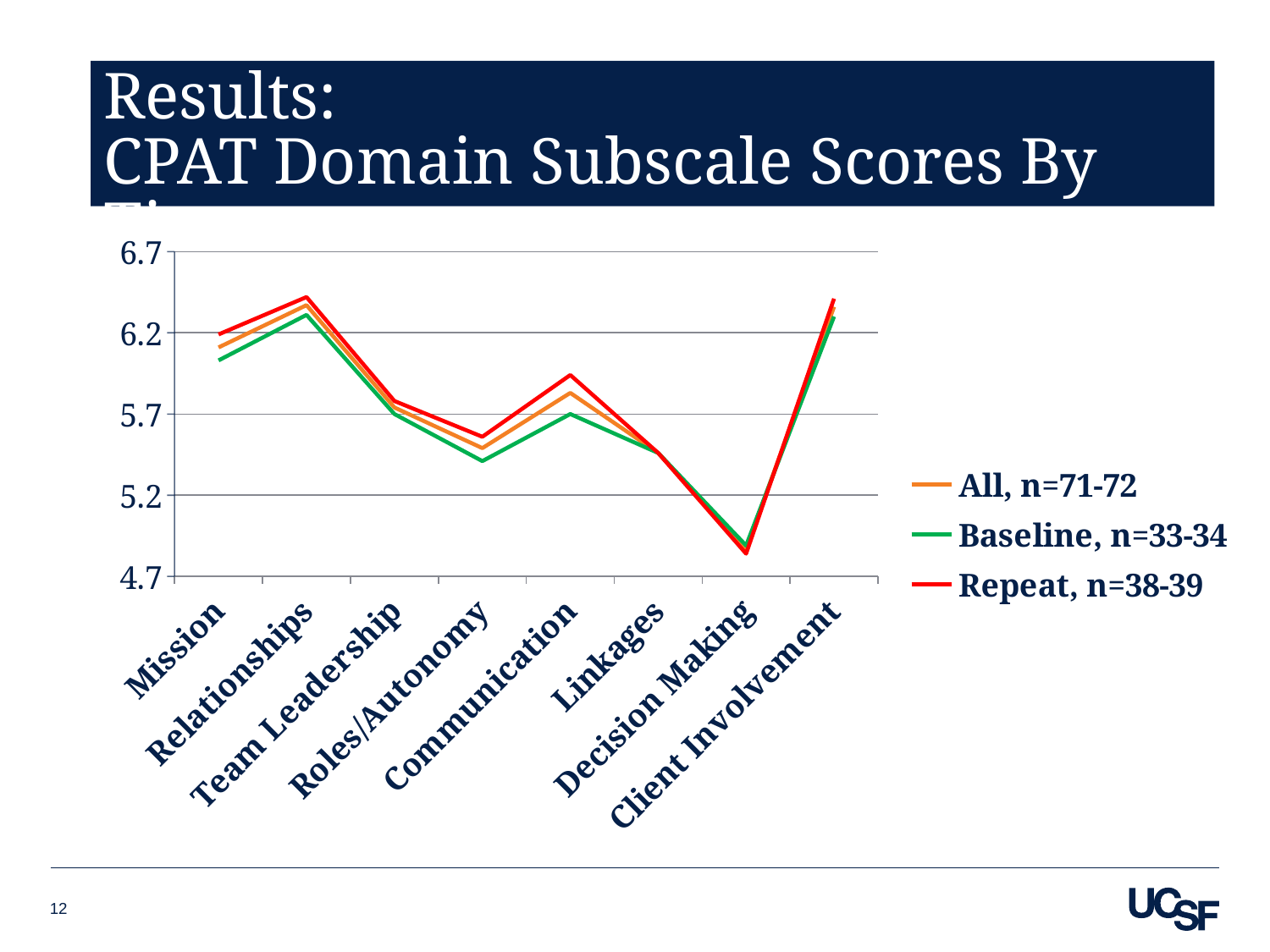
Which domain has the lowest score for the Baseline, n=33-34 series? Decision Making What colour is the line for the Repeat, n=38-39 series? red Do the Baseline, n=33-34 values rise or fall from Relationships to Roles/Autonomy? fall For Communication, which series has the higher value: Repeat, n=38-39 or Baseline, n=33-34? Repeat, n=38-39 Is the Baseline, n=33-34 value for Mission greater or less than 6.2? less What kind of chart is shown on the slide? line chart Is the Repeat, n=38-39 value for Decision Making greater or less than 5.2? less Which domain has the lowest score for the Repeat, n=38-39 series? Decision Making Is the Baseline, n=33-34 value for Roles/Autonomy greater or less than 5.7? less How many series does the legend list? 3 How many domain categories are plotted along the x axis? 8